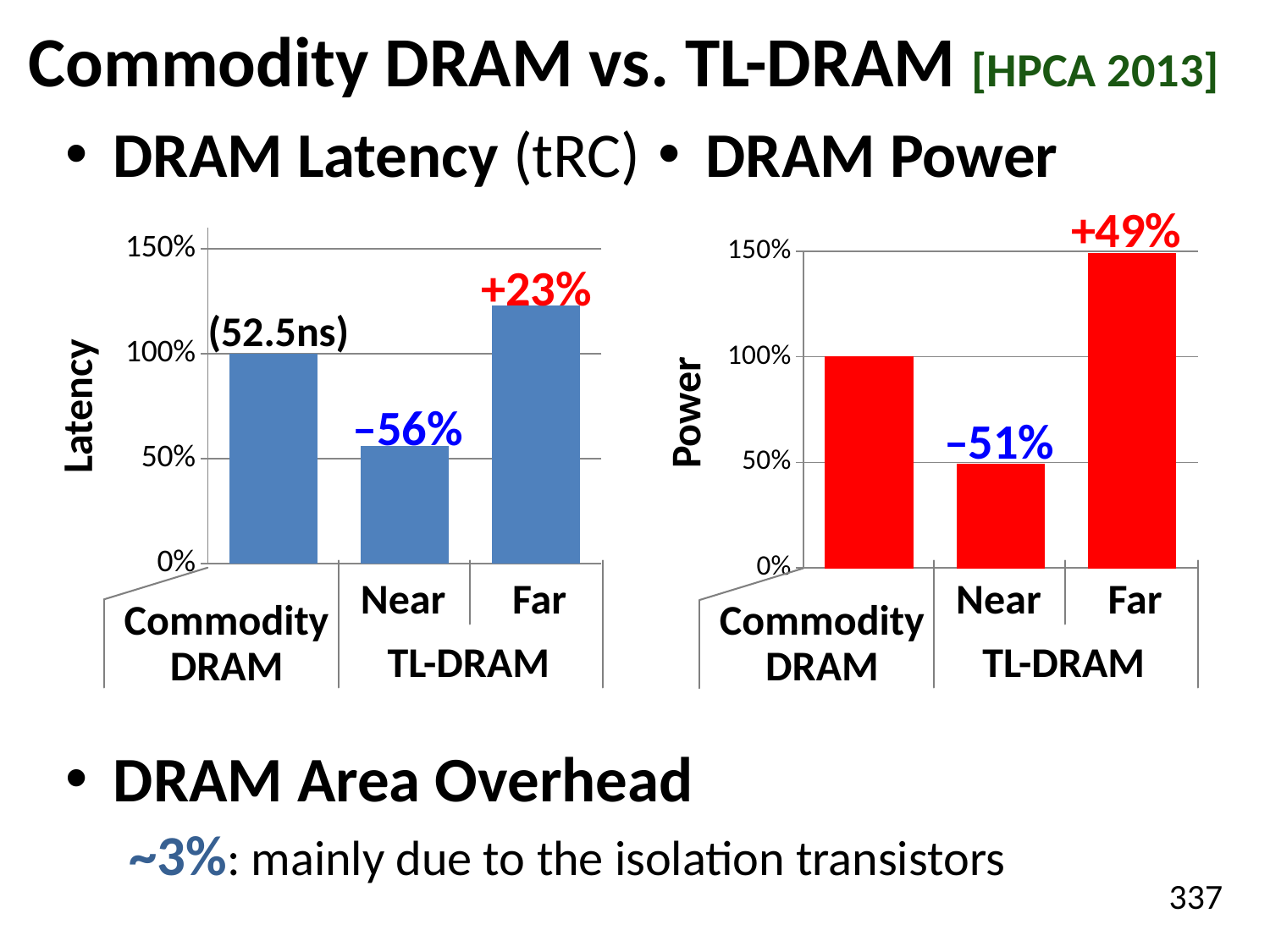
What type of chart is the DRAM Latency chart on the left? bar chart In the DRAM Latency chart, is the value for the Near bar greater or less than 50%? greater In the DRAM Latency chart, what is the latency value for Commodity DRAM? 100% In the DRAM Latency chart, what absolute latency is noted in parentheses above the Commodity DRAM bar? 52.5ns In the DRAM Latency chart, what percentage change is labeled above the Near bar of TL-DRAM? –56% In the DRAM Power chart, what is the power value for Commodity DRAM? 100% In the DRAM Power chart, which bar is the highest? Far In the DRAM Latency chart, which bar is the lowest? Near In the DRAM Latency chart, what percentage change is labeled above the Far bar of TL-DRAM? +23% In the DRAM Power chart, what percentage change is labeled above the Near bar of TL-DRAM? –51% In the DRAM Power chart, what percentage change is labeled above the Far bar of TL-DRAM? +49% How many bars are shown in the DRAM Power chart? 3